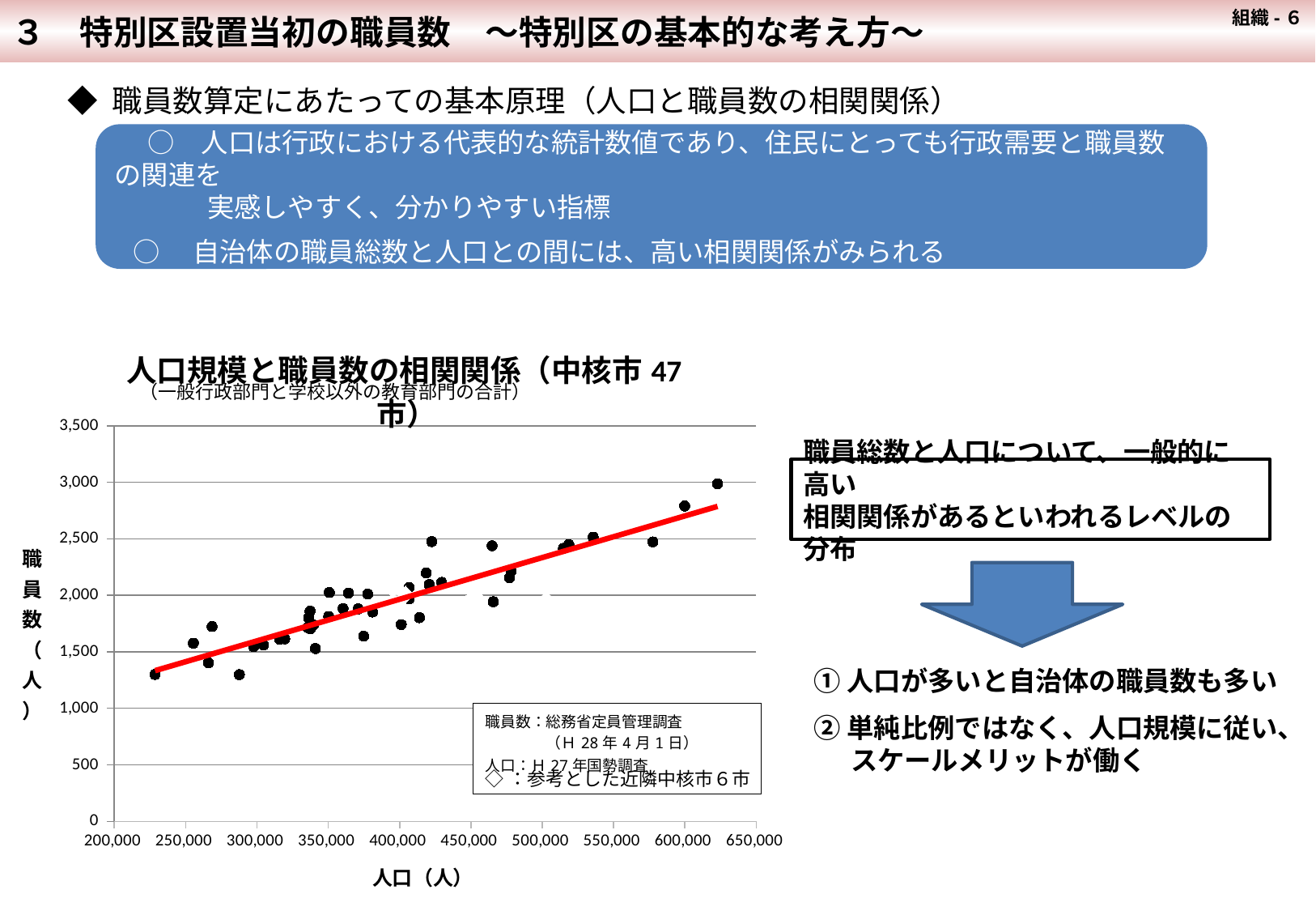
What is the highest value shown on the vertical axis of the chart? 3,500 What is the label of the horizontal axis of the chart? 人口（人） Do the plotted staff numbers generally rise or fall as population increases along the x axis? rise What kind of chart is shown on the slide? scatter chart Is the staff number for the point with the smallest population (around 230,000) greater or less than 1,500? less Is the staff number for the point at about 290,000 population greater or less than 1,500? less According to the chart title, how many 中核市 are plotted in the chart? 47 Is the staff number for the point at about 600,000 population greater or less than 2,500? greater